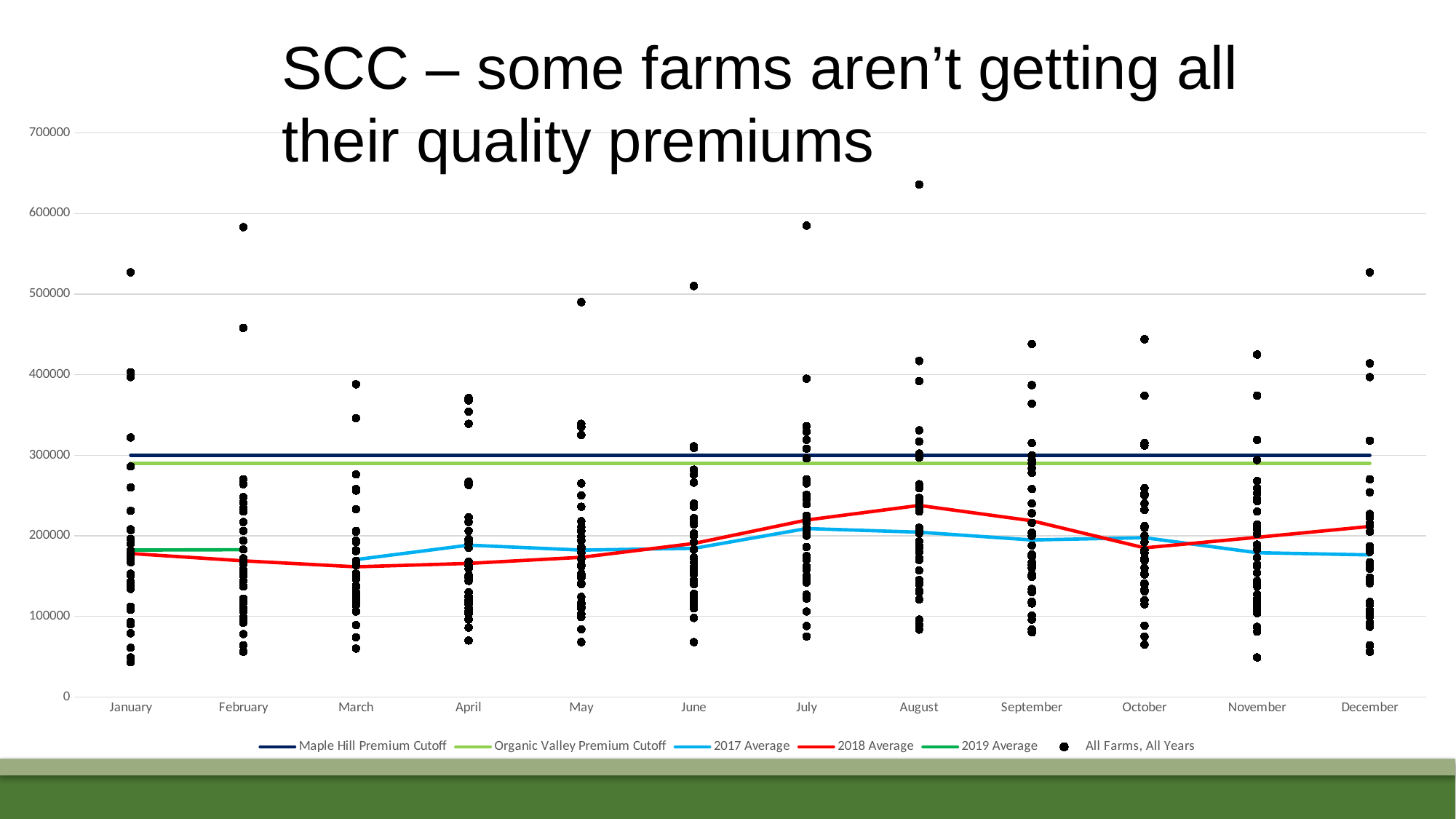
Does the 2018 Average rise or fall from March to August? rise Which premium cutoff line is higher, Maple Hill or Organic Valley? Maple Hill Premium Cutoff What kind of chart is shown on the slide? Line chart What colour is the 2018 Average line? Red Is the 2017 Average for December greater or less than 200000? less In August, which is larger, the 2017 Average or the 2018 Average? 2018 Average Is the 2018 Average for March greater or less than 200000? less How many months are shown along the x axis? 12 In which month is the 2018 Average at its highest? August What is the value of the Maple Hill Premium Cutoff line? 300000 Is the 2018 Average for August greater or less than 200000? greater How many series does the legend list? 6